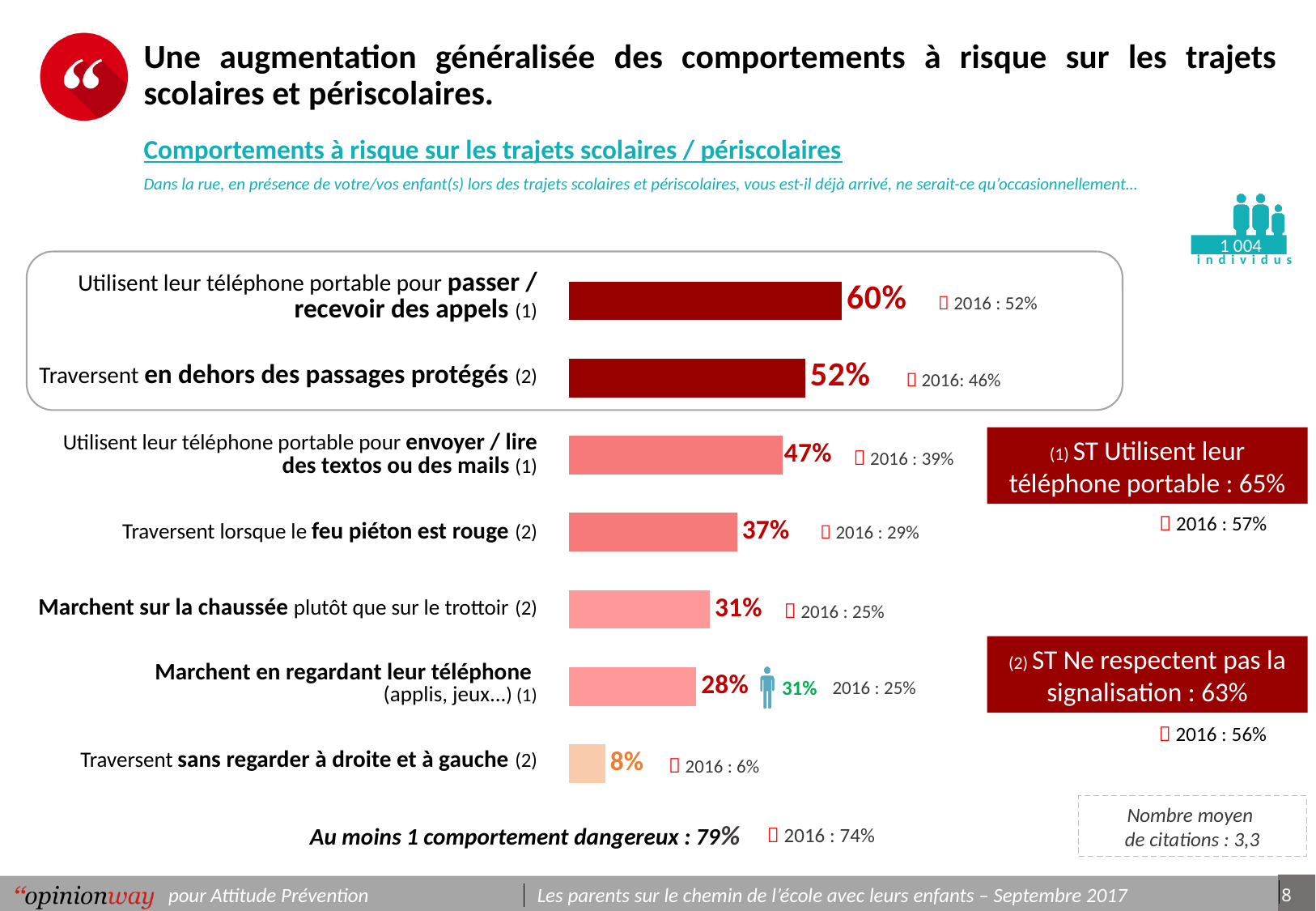
What is the difference in percentage points between "Utilisent leur téléphone portable pour envoyer / lire des textos ou des mails" (47%) and "Marchent sur la chaussée plutôt que sur le trottoir" (31%)? 16 percentage points What percentage of parents say they use their mobile phone to make or receive calls ("passer / recevoir des appels") during school journeys? 60% How many risk behaviours (bars) are plotted in the chart? 7 Which behaviour has the highest percentage in the chart? Utilisent leur téléphone portable pour passer / recevoir des appels What is the title of the chart? Comportements à risque sur les trajets scolaires / périscolaires What is the value shown for "Traversent lorsque le feu piéton est rouge"? 37% What is the 2016 value shown next to "Traversent en dehors des passages protégés"? 46% Which is larger: the value for "Traversent en dehors des passages protégés" or the value for "Marchent en regardant leur téléphone"? Traversent en dehors des passages protégés Which behaviour has the lowest percentage in the chart? Traversent sans regarder à droite et à gauche By how many percentage points did "Traversent lorsque le feu piéton est rouge" increase from 2016 (29%) to 2017 (37%)? 8 percentage points What kind of chart is used to show the risk behaviours? Bar chart Do the bar values rise or fall going from the top of the chart to the bottom? Fall